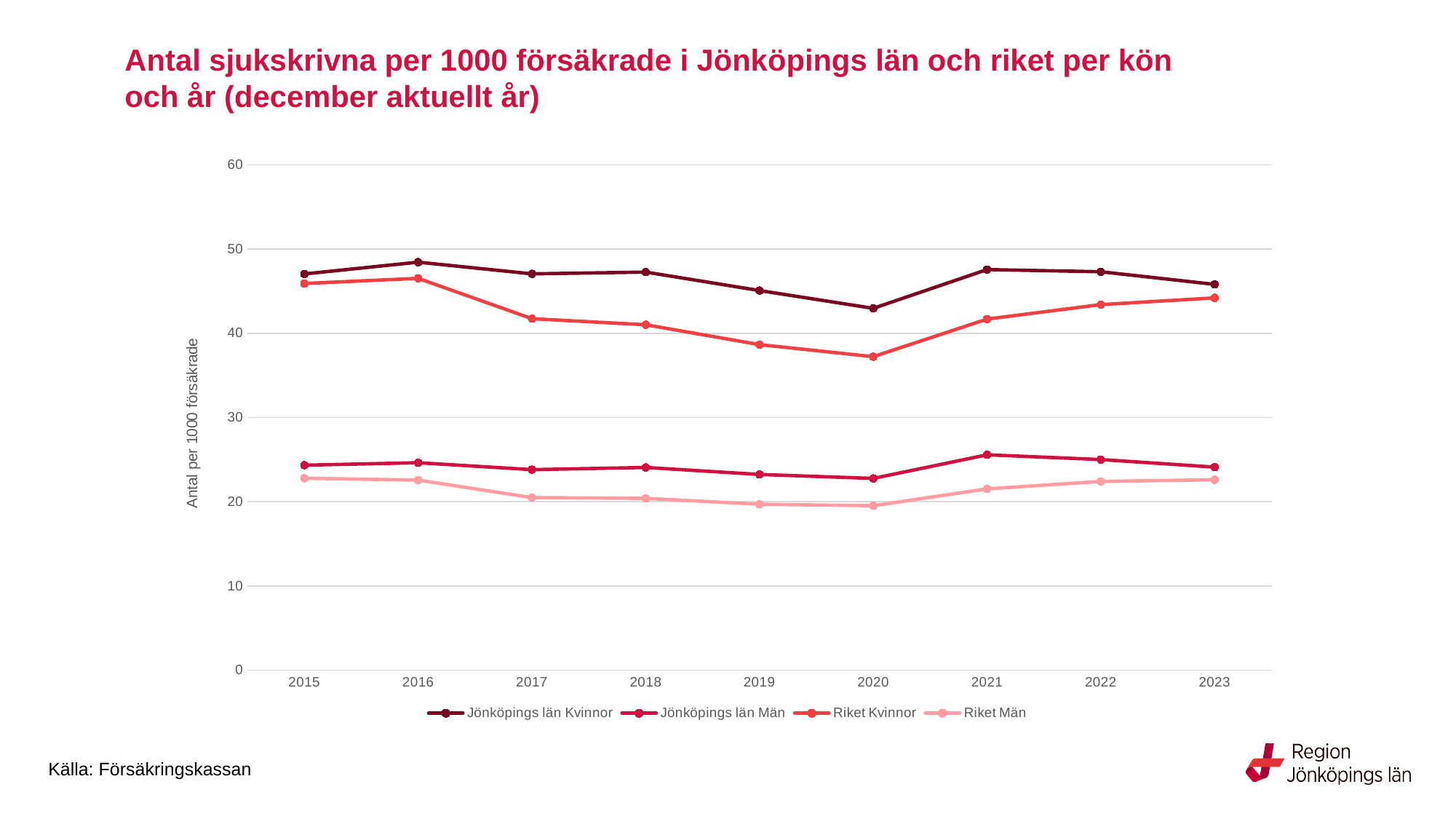
How many years are shown on the x axis? 9 What kind of chart is shown on the slide? line chart Is the value for Riket Kvinnor in 2020 greater or less than 40? less Does the value for Riket Kvinnor rise or fall from 2016 to 2020? fall In which year is the value for Riket Kvinnor lowest? 2020 In 2020, which is higher, Jönköpings län Kvinnor or Riket Kvinnor? Jönköpings län Kvinnor Is the value for Jönköpings län Män in 2021 greater or less than 20? greater What is the title of the y axis? Antal per 1000 försäkrade In 2015, which is higher, Jönköpings län Män or Riket Män? Jönköpings län Män How many series does the legend list? 4 In which year is the value for Jönköpings län Kvinnor highest? 2016 In which year is the value for Jönköpings län Kvinnor lowest? 2020